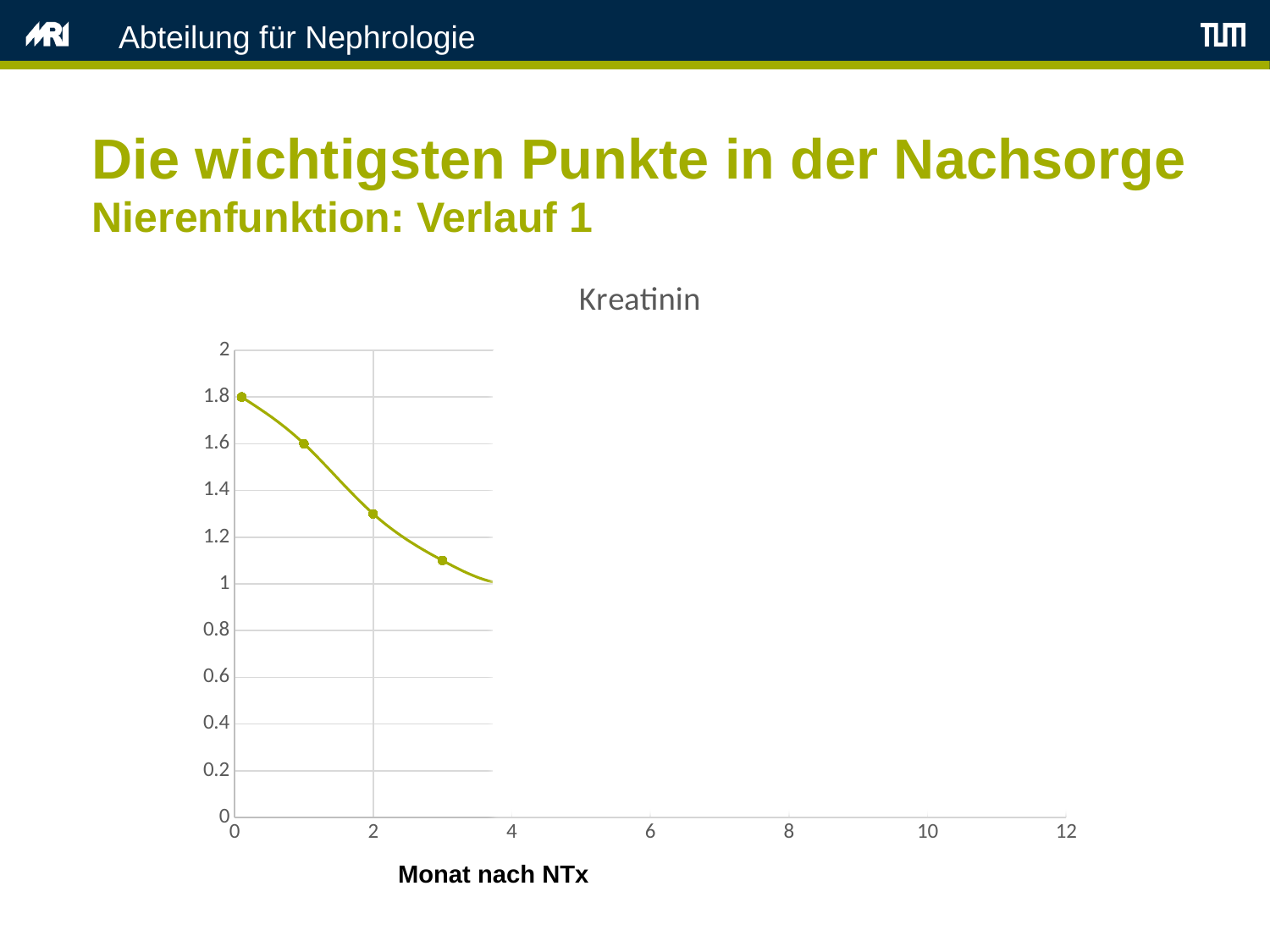
What kind of chart is shown on the slide? line chart Is the Kreatinin value at month 2 greater or less than 1.2? greater Which is larger, the Kreatinin value at month 0 or at month 2? month 0 What is the Kreatinin value at month 0? 1.8 What is the label of the x axis? Monat nach NTx Is the Kreatinin value at month 3 greater or less than 1? greater What is the Kreatinin value at month 1? 1.6 Do the Kreatinin values rise or fall as the months after NTx increase? fall What is the title of the chart? Kreatinin Is the Kreatinin value at month 3 greater or less than 1.2? less At which month is the Kreatinin value highest? 0